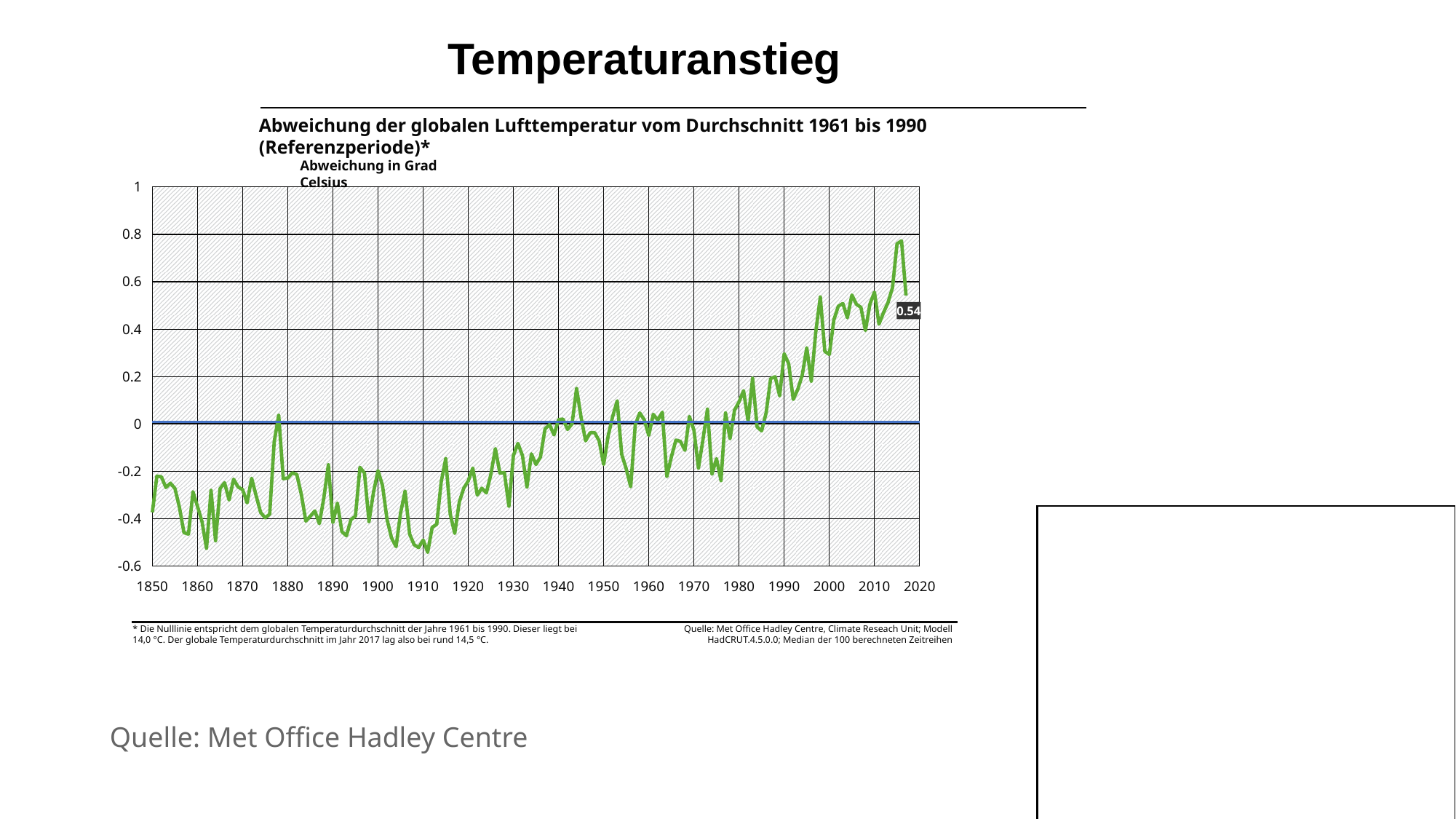
What is the label of the vertical axis? Abweichung in Grad Celsius Is the value for 1990 greater or less than 0? greater Is the lowest value on the line greater or less than -0.4? less Is the value for 1850 greater or less than 0? less What kind of chart is shown on the slide? line chart In which decade does the line reach its highest value? 2010s What is the value shown by the data label at the end of the line? 0.54 Which is larger, the value for 1950 or the value for 2010? 2010 Overall, do the values rise or fall from 1850 to 2020? rise What is the title of the chart? Abweichung der globalen Lufttemperatur vom Durchschnitt 1961 bis 1990 (Referenzperiode)*